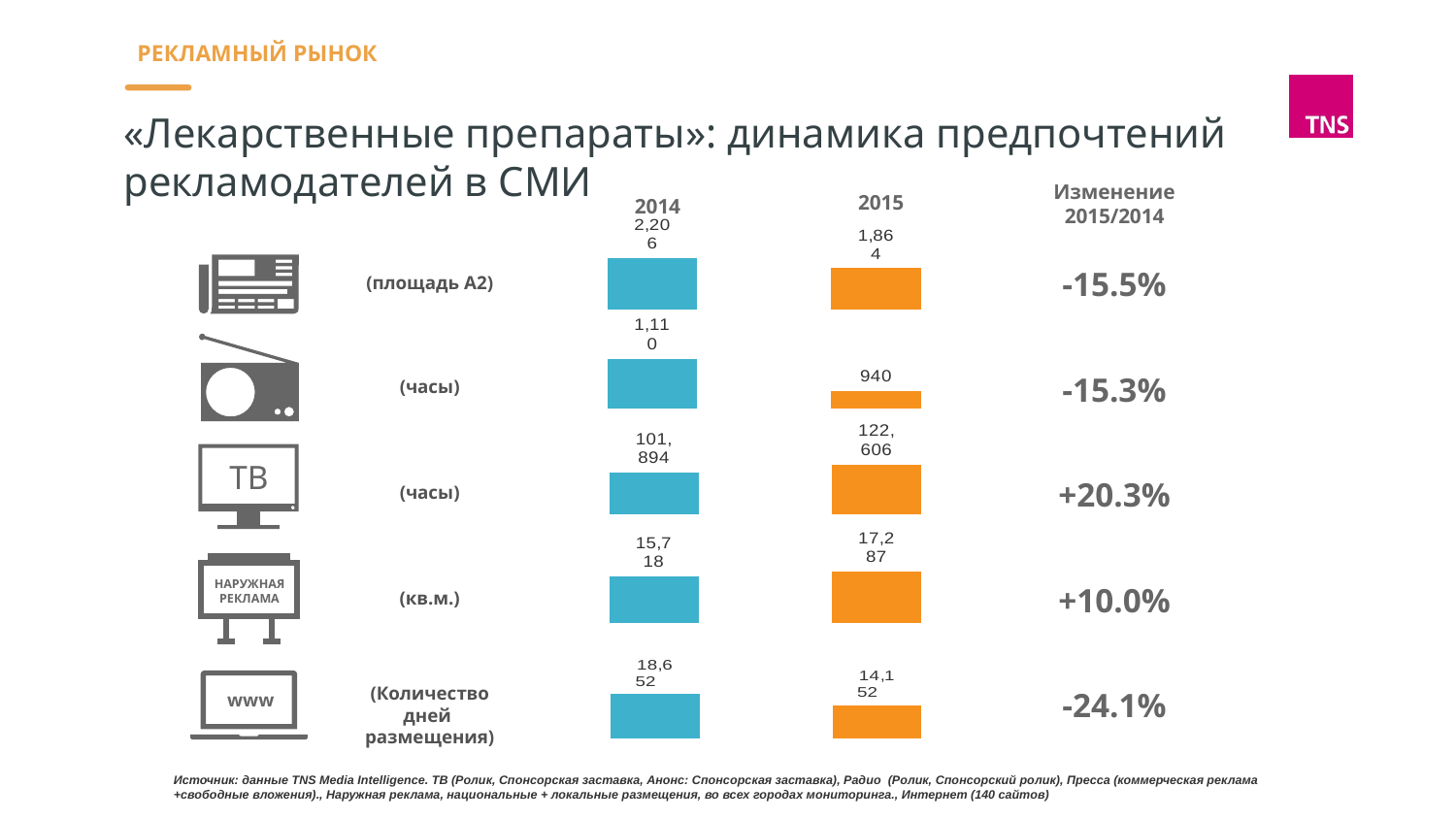
What is the Изменение 2015/2014 shown for the www (Количество дней размещения) row? -24.1% How many media rows are compared on the slide? 5 What is the 2015 value in the www (Количество дней размещения) row? 14,152 Which colour represents the 2015 bars? Orange What is the 2014 value in the (площадь А2) row? 2,206 By how much did the ТВ (часы) value increase from 2014 to 2015? 20,712 What is the Изменение 2015/2014 shown for the НАРУЖНАЯ РЕКЛАМА (кв.м.) row? +10.0% In the www (Количество дней размещения) row, which year has the larger value, 2014 or 2015? 2014 What is the 2014 value in the ТВ (часы) row? 101,894 Which row shows the most negative Изменение 2015/2014? www (Количество дней размещения), -24.1% What is the 2015 value in the ТВ (часы) row? 122,606 Which row shows the largest positive Изменение 2015/2014? ТВ (часы), +20.3%